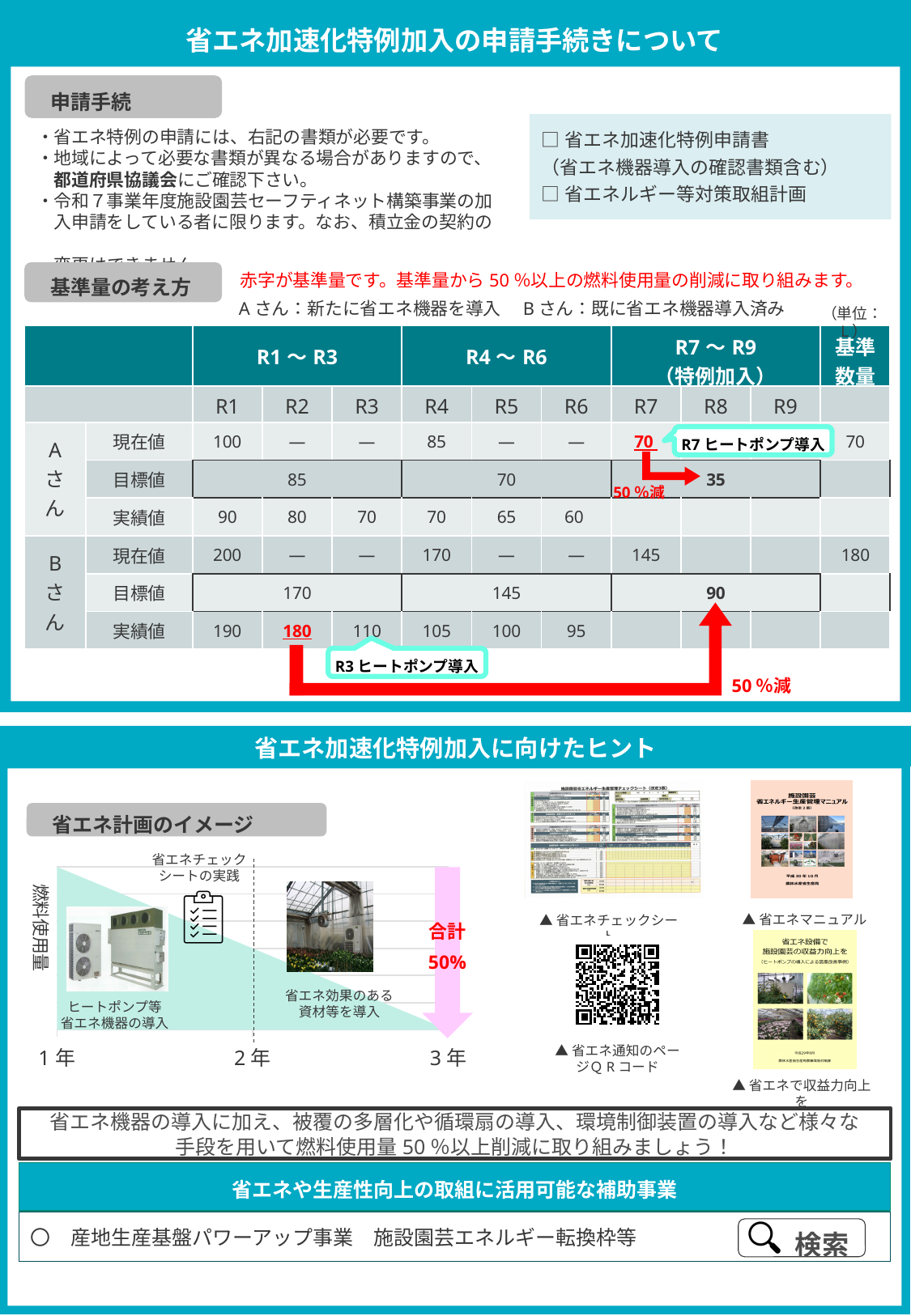
In the 省エネ計画のイメージ diagram, what total reduction (合計) is shown by the pink arrow at 3年? 50% In the 省エネ計画のイメージ diagram, which measure is shown for the first year: ヒートポンプ等省エネ機器の導入 or 省エネ効果のある資材等を導入? ヒートポンプ等省エネ機器の導入 In the 省エネ計画のイメージ diagram, does the fuel usage (燃料使用量) rise or fall from 1年 to 3年? fall What is the label on the vertical axis of the 省エネ計画のイメージ diagram? 燃料使用量 How many year points (1年, 2年, 3年) are shown along the x axis of the 省エネ計画のイメージ diagram? 3